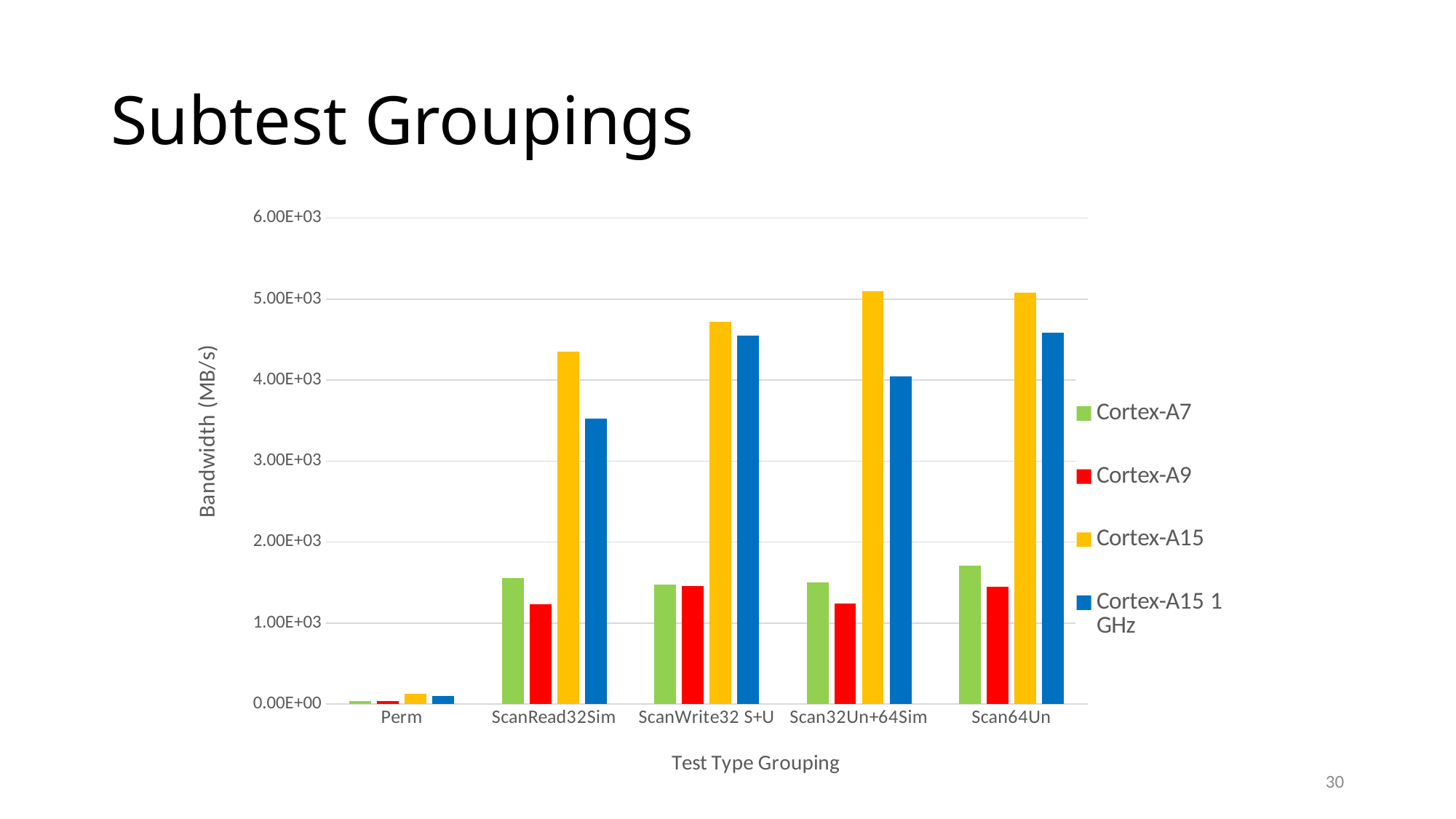
Is the Cortex-A9 value for ScanRead32Sim greater or less than 1.00E+03? greater Which test type grouping has the highest Cortex-A7 bandwidth? Scan64Un Is the Cortex-A7 value for Scan64Un greater or less than 2.00E+03? less Is the Cortex-A15 1 GHz value for ScanRead32Sim greater or less than 4.00E+03? less For Scan64Un, which is larger: Cortex-A7 or Cortex-A9? Cortex-A7 For ScanRead32Sim, which is larger: Cortex-A15 or Cortex-A15 1 GHz? Cortex-A15 Which series has the highest bandwidth for ScanRead32Sim? Cortex-A15 What kind of chart is shown on the slide? bar chart Which test type grouping has the lowest Cortex-A15 bandwidth? Perm What is the label of the y axis? Bandwidth (MB/s) How many test type groupings are shown on the x axis? 5 How many series does the legend list? 4